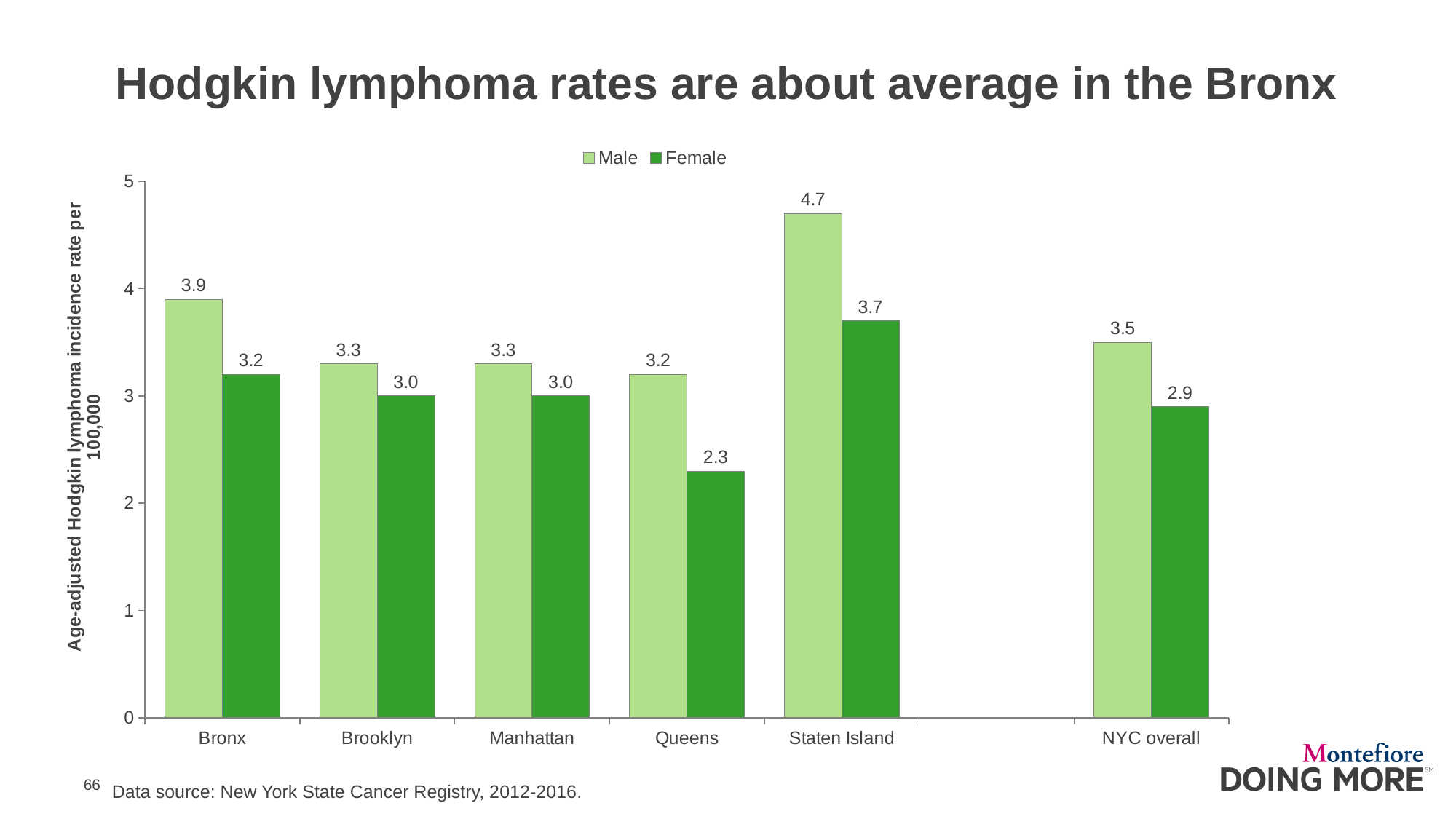
Which category has the lowest Female rate? Queens What is the label on the vertical axis? Age-adjusted Hodgkin lymphoma incidence rate per 100,000 What is the Female Hodgkin lymphoma incidence rate for Queens? 2.3 What is the difference between the Male and Female rates in Staten Island? 1.0 What kind of chart is shown on the slide? Bar chart What is the Female rate for NYC overall? 2.9 How many categories are shown on the x axis? 6 How many series does the legend list? 2 What is the Male Hodgkin lymphoma incidence rate for the Bronx? 3.9 Which is larger, the Female rate in the Bronx or the Female rate in Brooklyn? Bronx What is the difference between the Bronx Male rate and the NYC overall Male rate? 0.4 Which borough has the highest Male Hodgkin lymphoma incidence rate? Staten Island